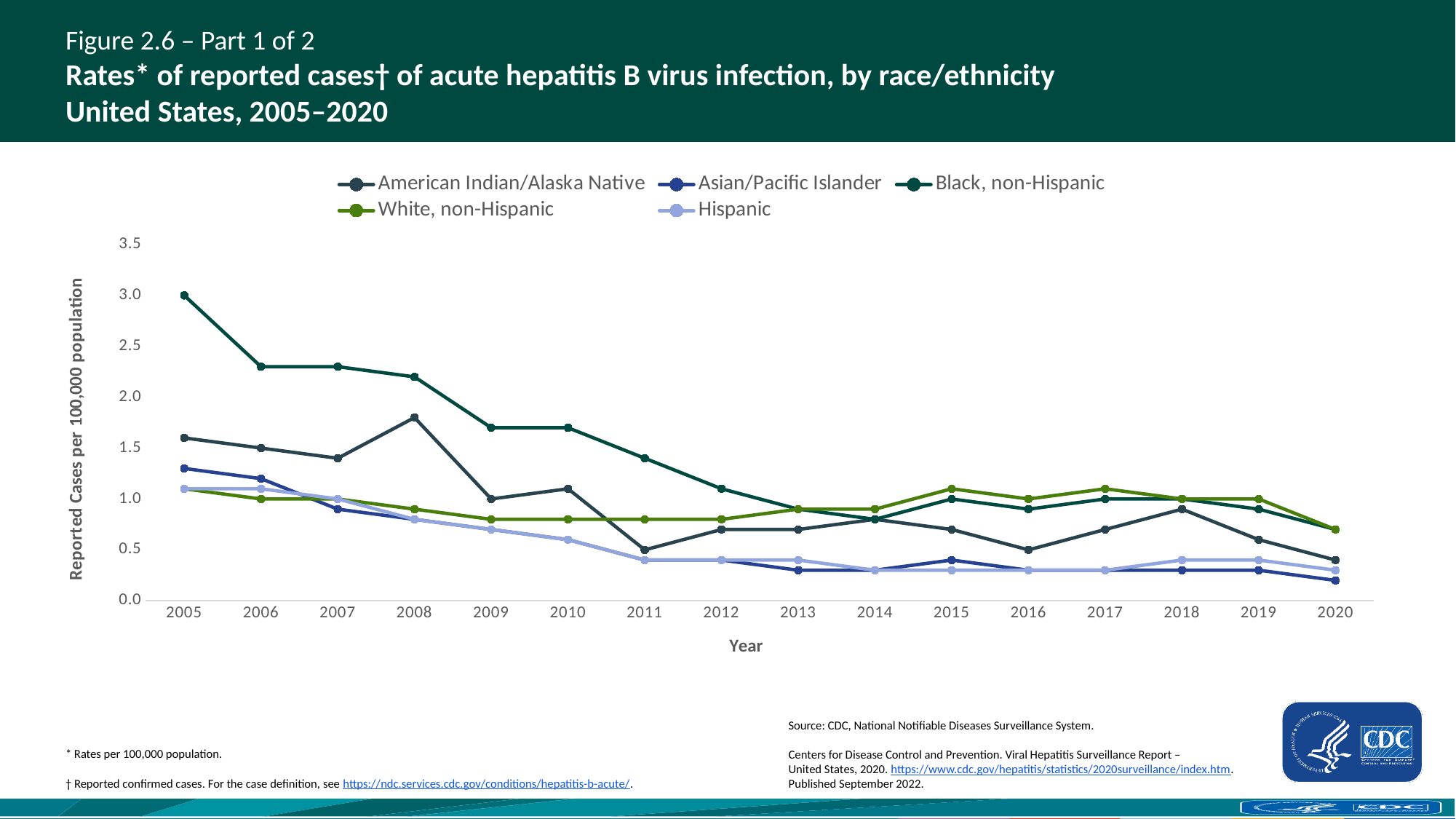
Is the rate for American Indian/Alaska Native in 2008 greater or less than 1.5? greater How many years are shown on the x axis? 16 In 2015, which had the higher rate: White, non-Hispanic or Hispanic? White, non-Hispanic Is the rate for Black, non-Hispanic in 2005 greater or less than 2.5? greater Which race/ethnicity group had the highest rate in 2005? Black, non-Hispanic Does the rate for Black, non-Hispanic rise or fall from 2005 to 2020? fall What type of chart is shown on the slide? line chart Which race/ethnicity group had the highest rate in 2008? Black, non-Hispanic Which race/ethnicity group had the lowest rate in 2020? Asian/Pacific Islander Is the rate for Hispanic in 2020 greater or less than 0.5? less What is the title of the y axis? Reported Cases per 100,000 population How many series does the legend list? 5